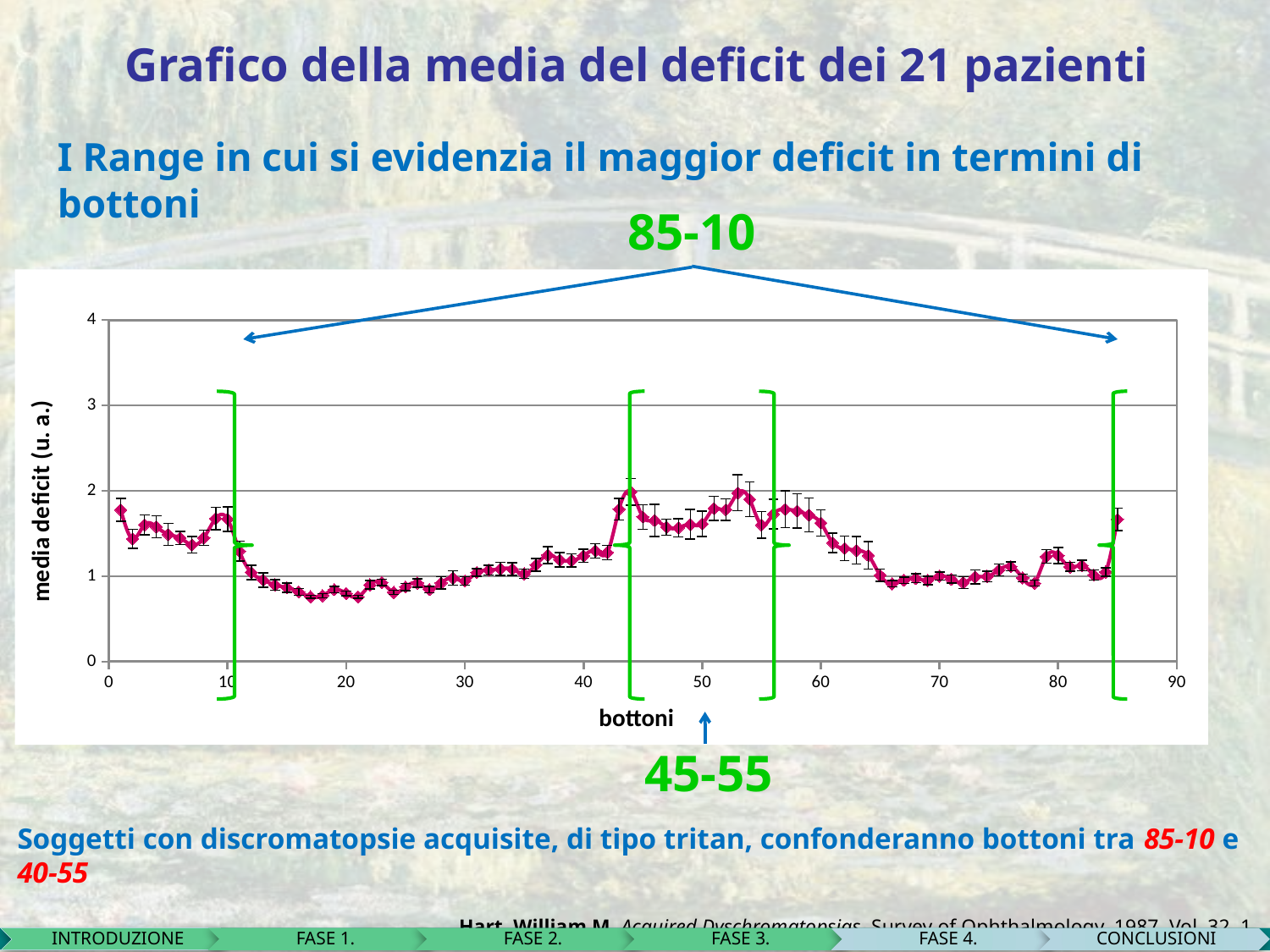
Is the value for bottone 70 greater or less than 2? less Do the values rise or fall along the x axis between bottone 10 and bottone 17? fall Which has the larger value, bottone 10 or bottone 30? bottone 10 Is the value for bottone 50 greater or less than 1? greater Is the value for bottone 1 greater or less than 1? greater What is the label of the x axis of the chart? bottoni Which has the larger value, bottone 20 or bottone 50? bottone 50 Do the values rise or fall along the x axis between bottone 30 and bottone 43? rise What kind of chart is shown on the slide? line chart What is the label of the y axis of the chart? media deficit (u. a.)